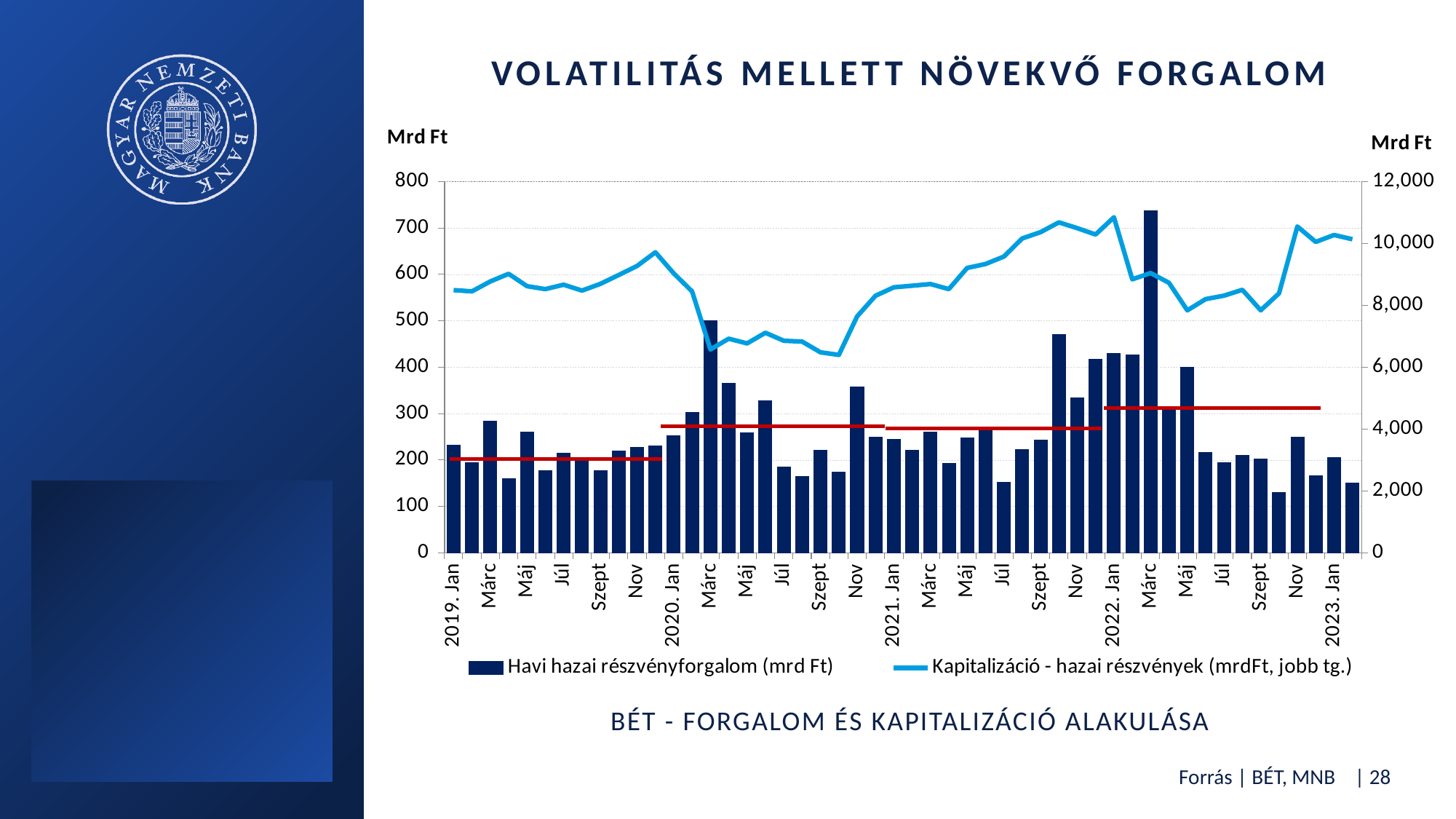
Is the monthly domestic equity turnover bar for 2019 January greater or less than 200? greater Is the monthly domestic equity turnover bar for 2022 October greater or less than 200? less Is the monthly domestic equity turnover bar for 2020 March greater or less than 400? greater What kind of chart is shown on the slide? Combined bar and line chart What is the title shown below the chart? BÉT - Forgalom és kapitalizáció alakulása Does the capitalization line (Kapitalizáció - hazai részvények) rise or fall between 2020 January and 2020 March? Fall Which month has the highest monthly domestic equity turnover (Havi hazai részvényforgalom) bar? 2022 March (Márc) How many series does the legend list? 2 What unit is shown on the left vertical axis? Mrd Ft Which is larger, the turnover bar for 2022 March or the turnover bar for 2020 March? 2022 March